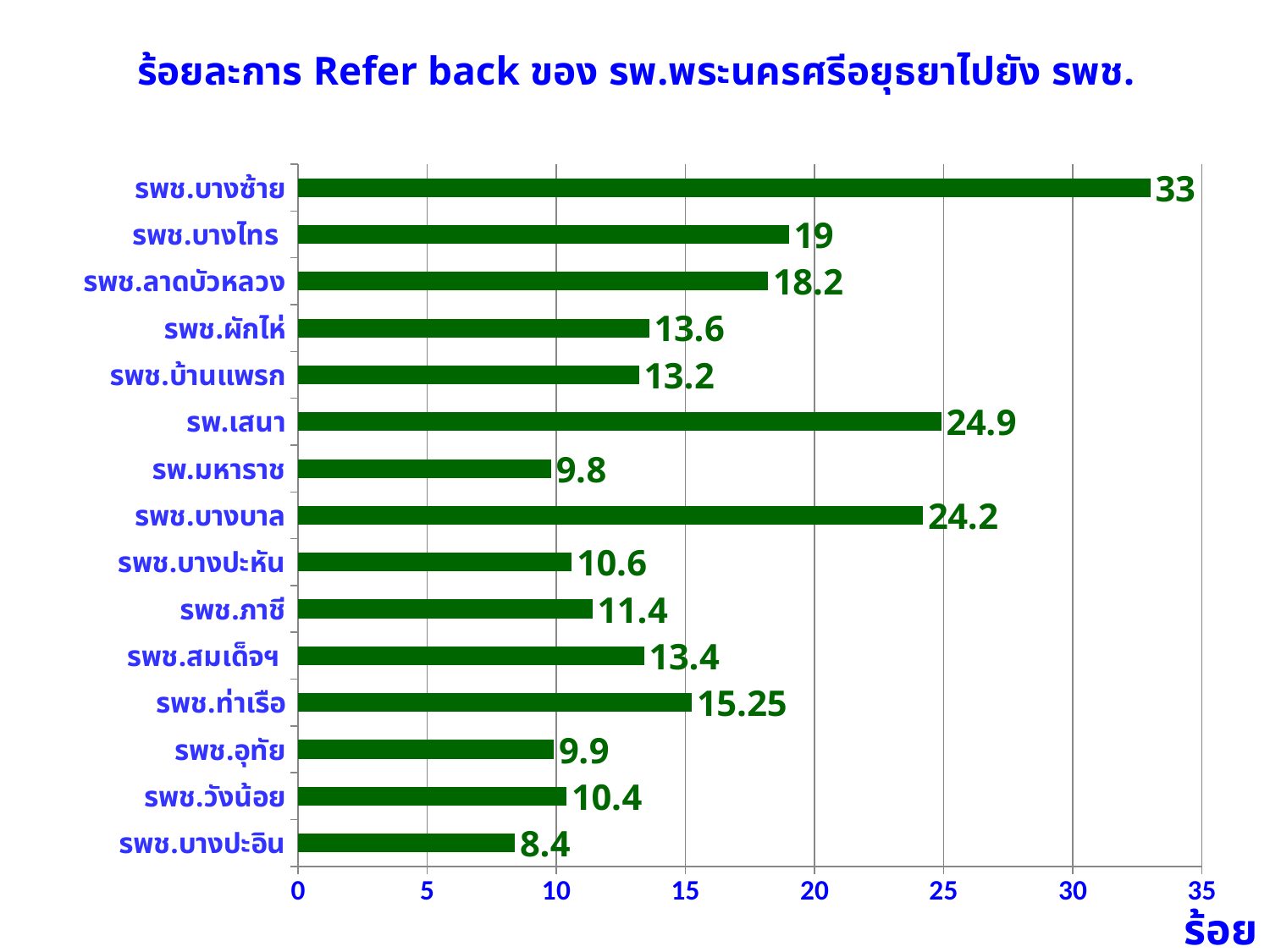
What is the difference between the values for รพ.เสนา and รพช.บางบาล? 0.7 What is the value for รพ.เสนา? 24.9 Which category has the highest value? รพช.บางซ้าย What is the value for รพช.ท่าเรือ? 15.25 What is the title of the chart? ร้อยละการ Refer back ของ รพ.พระนครศรีอยุธยาไปยัง รพช. What is the difference between the values for รพช.บางซ้าย and รพช.บางไทร? 14 What type of chart is shown on the slide? bar chart How many categories are shown in the chart? 15 Which category has the lowest value? รพช.บางปะอิน Which is larger, the value for รพช.ลาดบัวหลวง or the value for รพช.ภาชี? รพช.ลาดบัวหลวง What is the value for รพช.บางปะอิน? 8.4 What is the value for รพช.บางซ้าย? 33